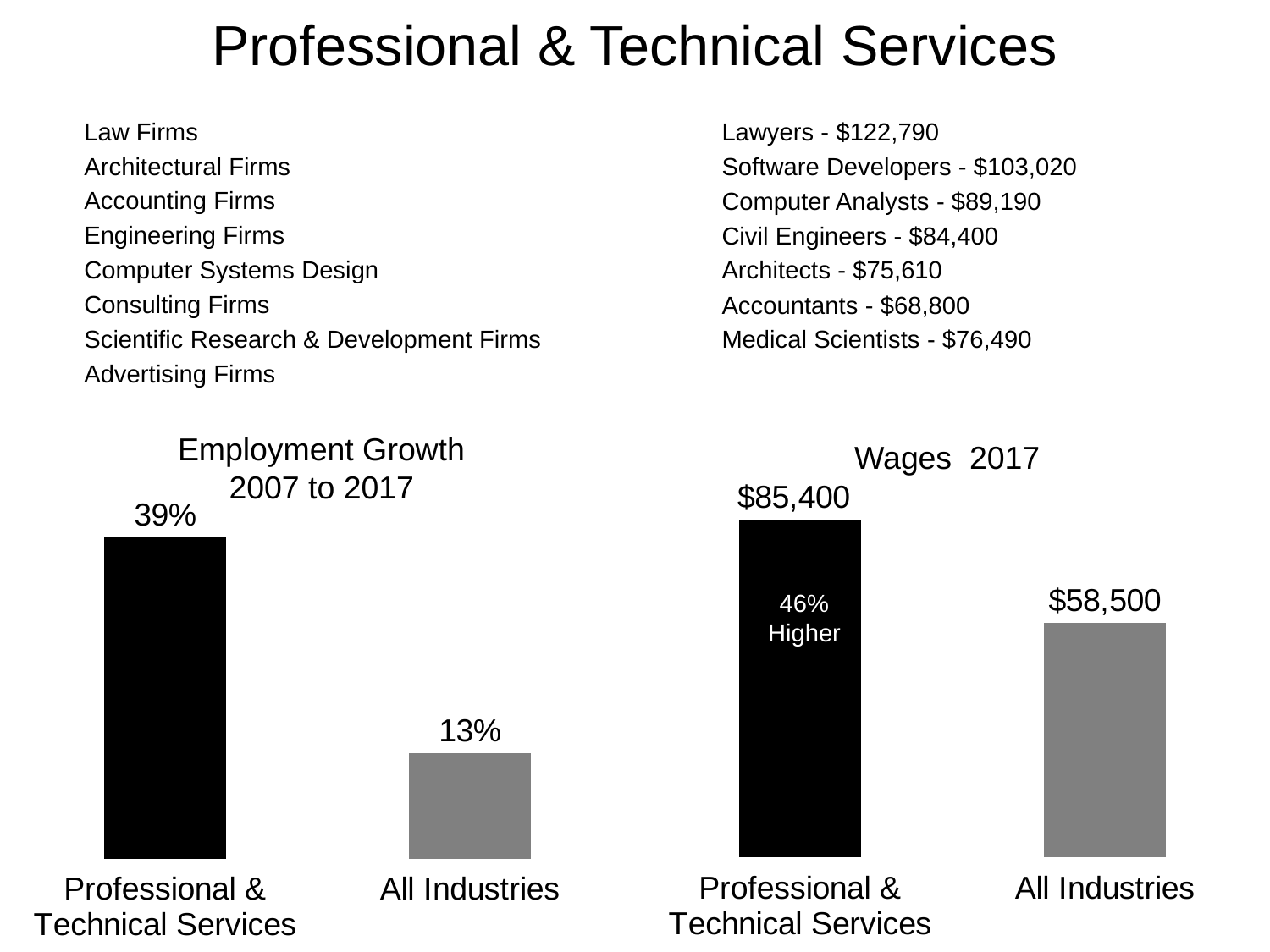
In the Employment Growth 2007 to 2017 chart, what is the value for Professional & Technical Services? 39% In the Wages 2017 chart, is the value for Professional & Technical Services larger or smaller than the value for All Industries? larger In the Employment Growth 2007 to 2017 chart, how many categories are shown? 2 In the Wages 2017 chart, what is the value for Professional & Technical Services? $85,400 In the Employment Growth 2007 to 2017 chart, which category has the highest value? Professional & Technical Services In the Wages 2017 chart, which category has the lowest value? All Industries In the Wages 2017 chart, what is the difference between Professional & Technical Services and All Industries? $26,900 In the Wages 2017 chart, what is the value for All Industries? $58,500 In the Wages 2017 chart, what text is printed inside the Professional & Technical Services bar? 46% Higher What kind of chart is the Wages 2017 chart? bar chart In the Employment Growth 2007 to 2017 chart, what is the value for All Industries? 13% In the Employment Growth 2007 to 2017 chart, what is the difference between Professional & Technical Services and All Industries? 26%